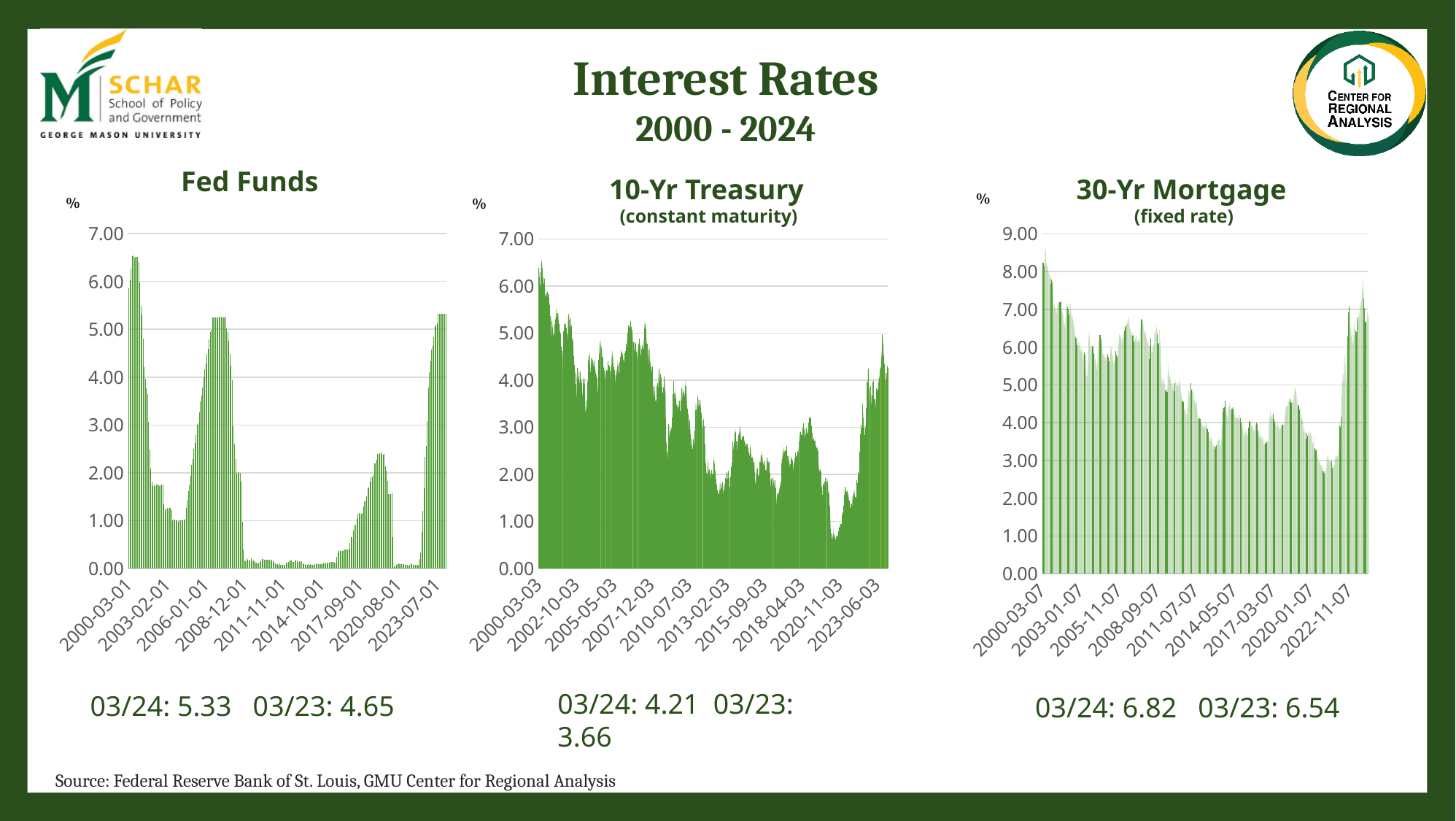
On the 10-Yr Treasury chart, is the lowest value around 2020 greater or less than 1.00? less On the 10-Yr Treasury chart, what is the value shown for 03/24? 4.21 How many charts are shown on the slide? 3 On the Fed Funds chart, what is the value shown for 03/24? 5.33 On the 30-Yr Mortgage chart, what is the difference between the 03/24 value and the 03/23 value? 0.28 What kind of chart is the Fed Funds chart? bar chart On the Fed Funds chart, which is larger, the 03/24 value or the 03/23 value? 03/24 On the Fed Funds chart, what is the value shown for 03/23? 4.65 On the Fed Funds chart, is the peak value around 2000 greater or less than 6.00? greater On the 30-Yr Mortgage chart, is the value at the start of 2000 greater or less than 8.00? greater On the 10-Yr Treasury chart, what is the difference between the 03/24 value and the 03/23 value? 0.55 On the 30-Yr Mortgage chart, what is the value shown for 03/23? 6.54